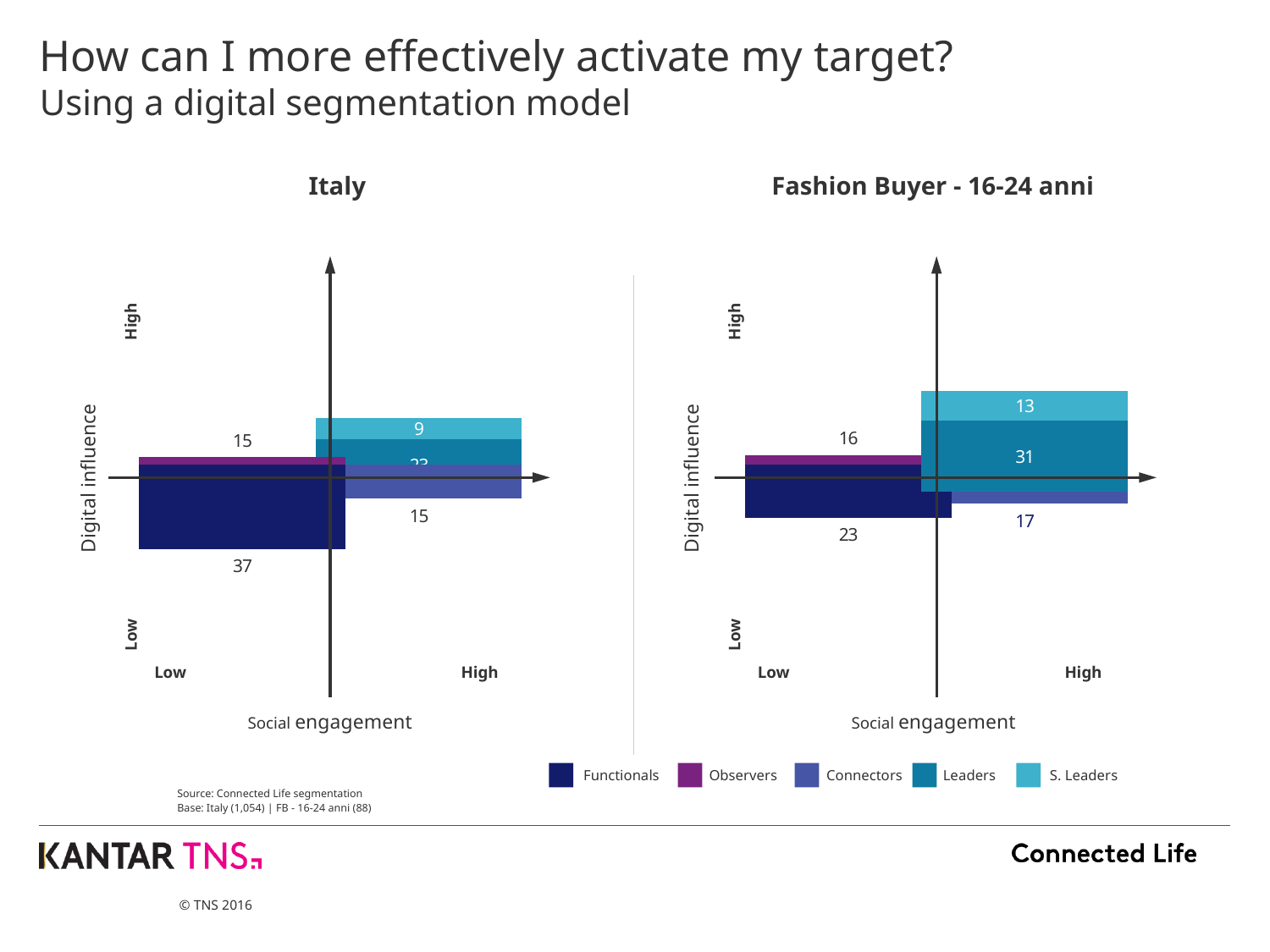
In the Italy chart, what is the value for Observers? 15 How many segments does the legend list? 5 In the Fashion Buyer - 16-24 anni chart, which segment has the lowest value? S. Leaders In the Fashion Buyer - 16-24 anni chart, which segment has the highest value? Leaders In the Italy chart, what is the difference between the Functionals value and the S. Leaders value? 28 In the Italy chart, what is the value for S. Leaders? 9 In the Italy chart, what is the value for Functionals? 37 In the Fashion Buyer - 16-24 anni chart, what is the value for S. Leaders? 13 In the Fashion Buyer - 16-24 anni chart, what is the value for Connectors? 17 In the Fashion Buyer - 16-24 anni chart, what is the value for Leaders? 31 In the Italy chart, which segment has the highest value? Functionals In the Fashion Buyer - 16-24 anni chart, what is the value for Functionals? 23